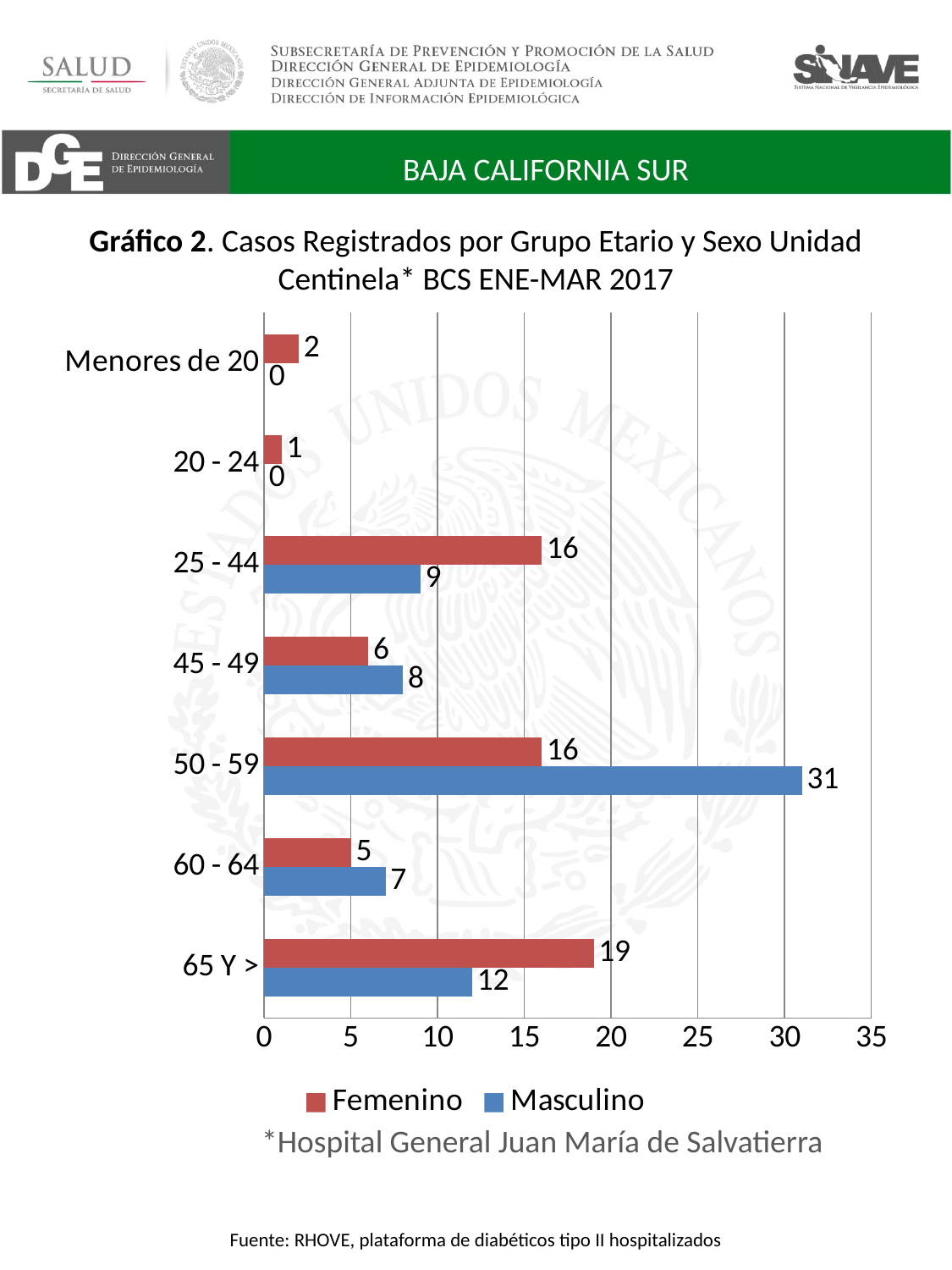
Which age group has the highest Femenino value? 65 Y > What is the Masculino value for the 50 - 59 age group? 31 What is the total of the Femenino and Masculino values for the 60 - 64 age group? 12 What kind of chart is shown on the slide? Bar chart What is the difference between the Masculino and Femenino values for the 50 - 59 age group? 15 Which age group has the highest Masculino value? 50 - 59 Which series is shown in red in the legend? Femenino What is the Masculino value for the 25 - 44 age group? 9 What is the Femenino value for the 65 Y > age group? 19 Which is larger for the 45 - 49 age group, the Femenino value or the Masculino value? Masculino How many series does the legend list? 2 How many age groups are shown on the chart? 7